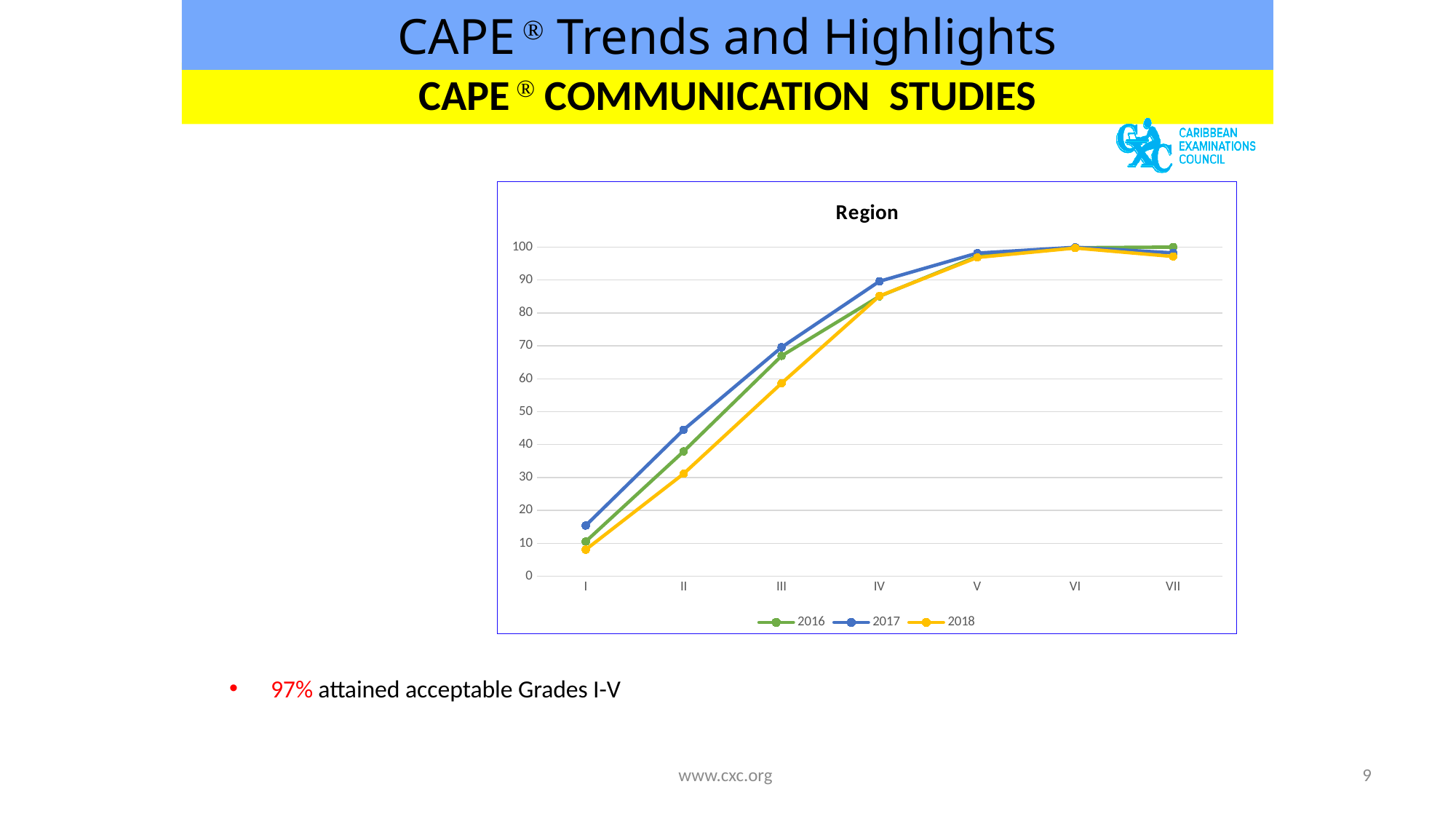
Which series has the lowest value at grade I? 2018 Is the value for 2017 at grade II greater or less than 40? greater Is the value for 2018 at grade II greater or less than 40? less Which years are listed in the chart's legend? 2016, 2017, 2018 How many series does the chart's legend list? 3 Is the value for 2018 at grade I greater or less than 10? less Do the values for the 2017 series rise or fall from grade I to grade VI? rise How many categories are shown along the x axis of the chart? 7 What kind of chart is shown on the slide? line chart What is the title of the chart? Region At grade II, which series has the larger value, 2017 or 2018? 2017